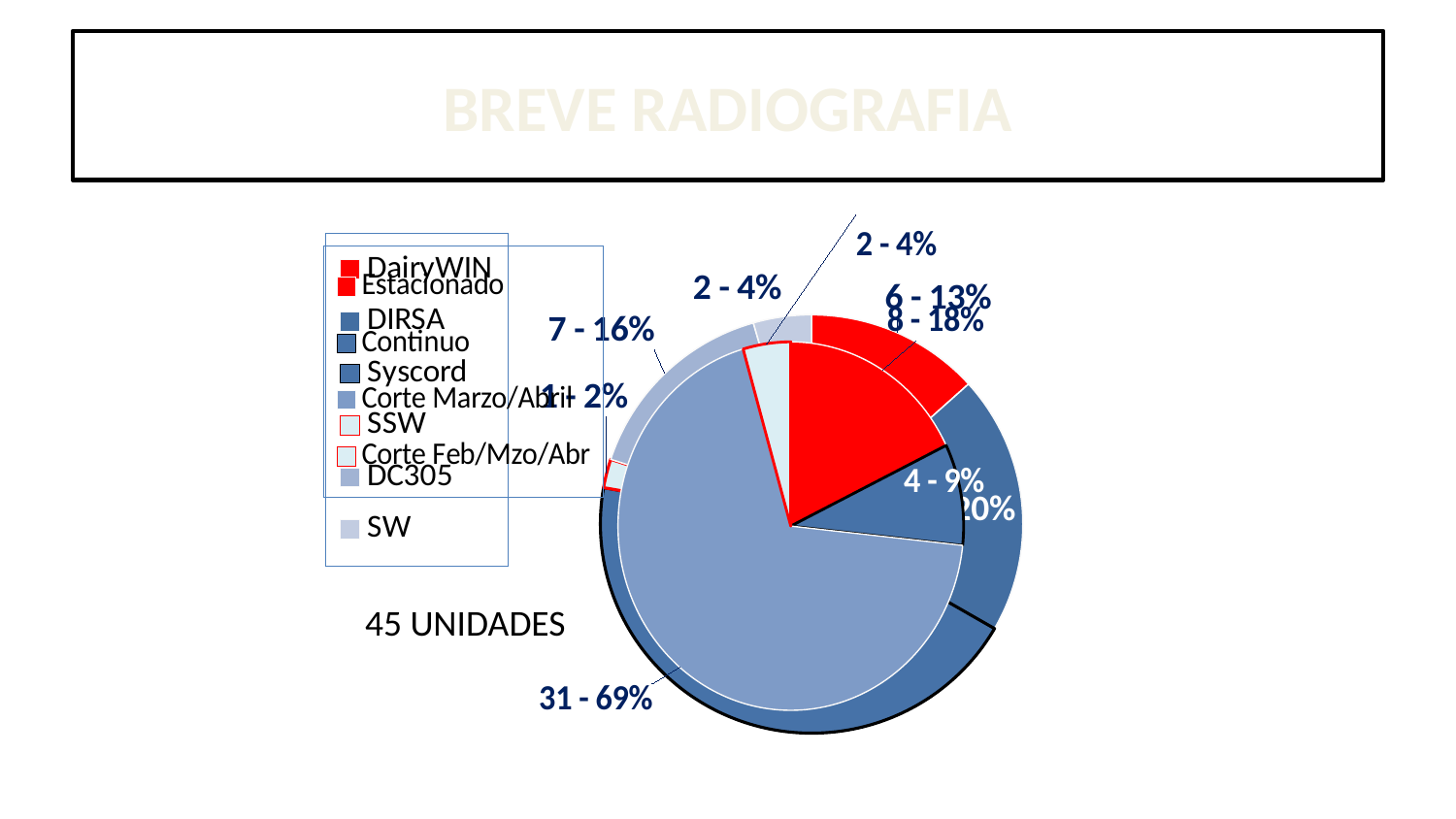
What text appears below the legend of the chart? 45 UNIDADES What count is shown next to 69% on the pie chart? 31 What count is shown next to 13% on the pie chart? 6 What is the largest data label shown on the pie chart? 31 - 69% What is the smallest data label shown on the pie chart? 1 - 2% What percentage is shown next to the count of 7 on the pie chart? 16% Is the share of the largest slice greater or less than 50%? greater What colour represents DairyWIN in the legend? red Which is larger, the slice labelled 8 - 18% or the slice labelled 4 - 9%? 8 - 18% How many data labels on the chart read "2 - 4%"? 2 How many more units does the slice labelled 31 - 69% have than the slice labelled 4 - 9%? 27 What kind of chart is shown on the slide? pie chart